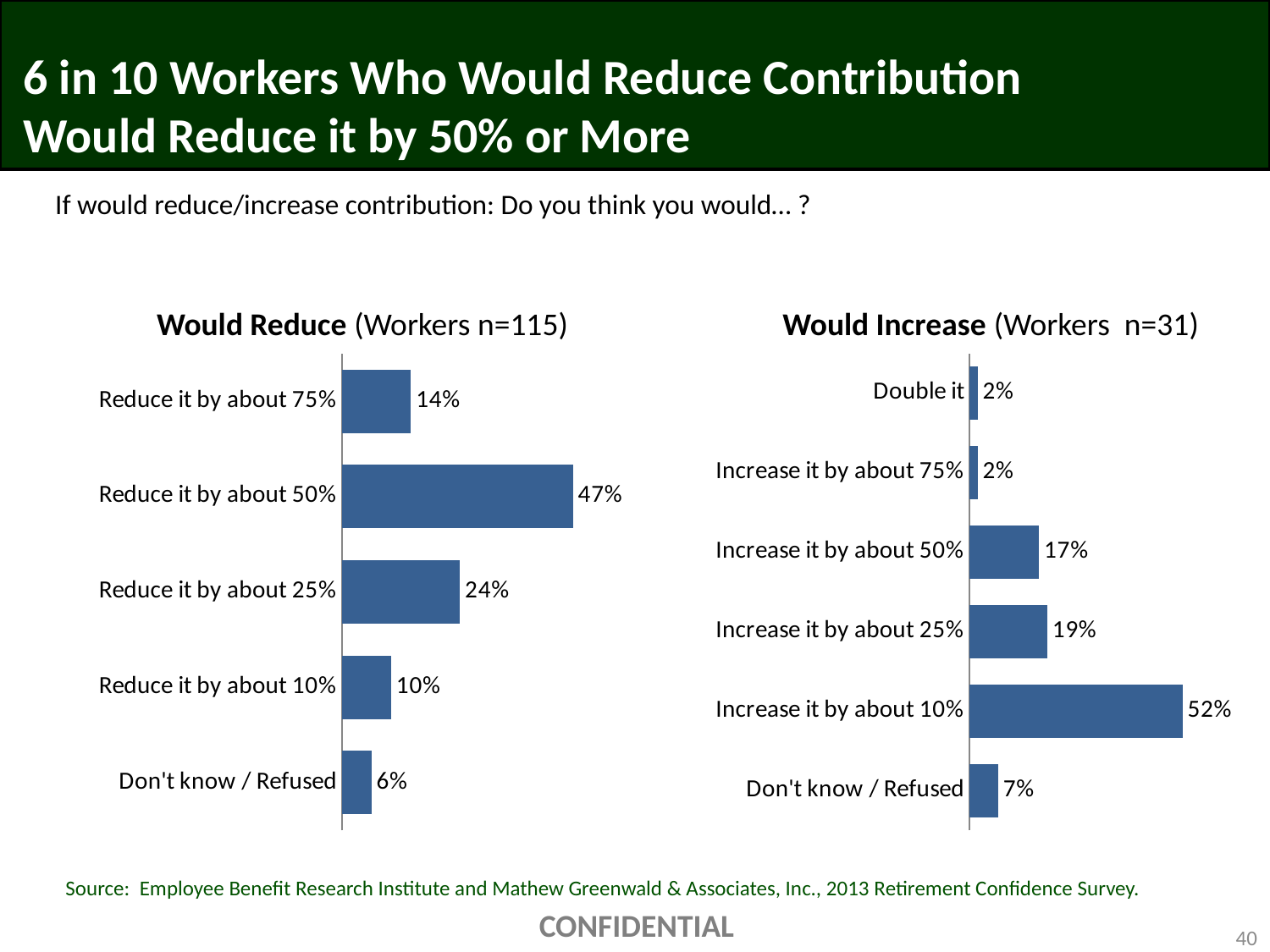
In the 'Would Reduce' chart, what is the difference between 'Reduce it by about 50%' and 'Reduce it by about 25%'? 23% In the 'Would Reduce' chart, which category has the lowest value? Don't know / Refused What is the sample size (n) shown in the title of the 'Would Increase' chart? 31 In the 'Would Reduce' chart, what percentage of workers would reduce it by about 50%? 47% How many categories are shown in the 'Would Reduce' chart? 5 What type of chart is the 'Would Reduce' chart? Bar chart In the 'Would Increase' chart, what is the difference between 'Increase it by about 25%' and 'Increase it by about 50%'? 2% In the 'Would Reduce' chart, which category has the highest value? Reduce it by about 50% How many categories are shown in the 'Would Increase' chart? 6 In the 'Would Increase' chart, which category has the highest value? Increase it by about 10% In the 'Would Increase' chart, what percentage of workers would increase it by about 10%? 52% In the 'Would Reduce' chart, which is larger: 'Reduce it by about 75%' or 'Reduce it by about 10%'? Reduce it by about 75%